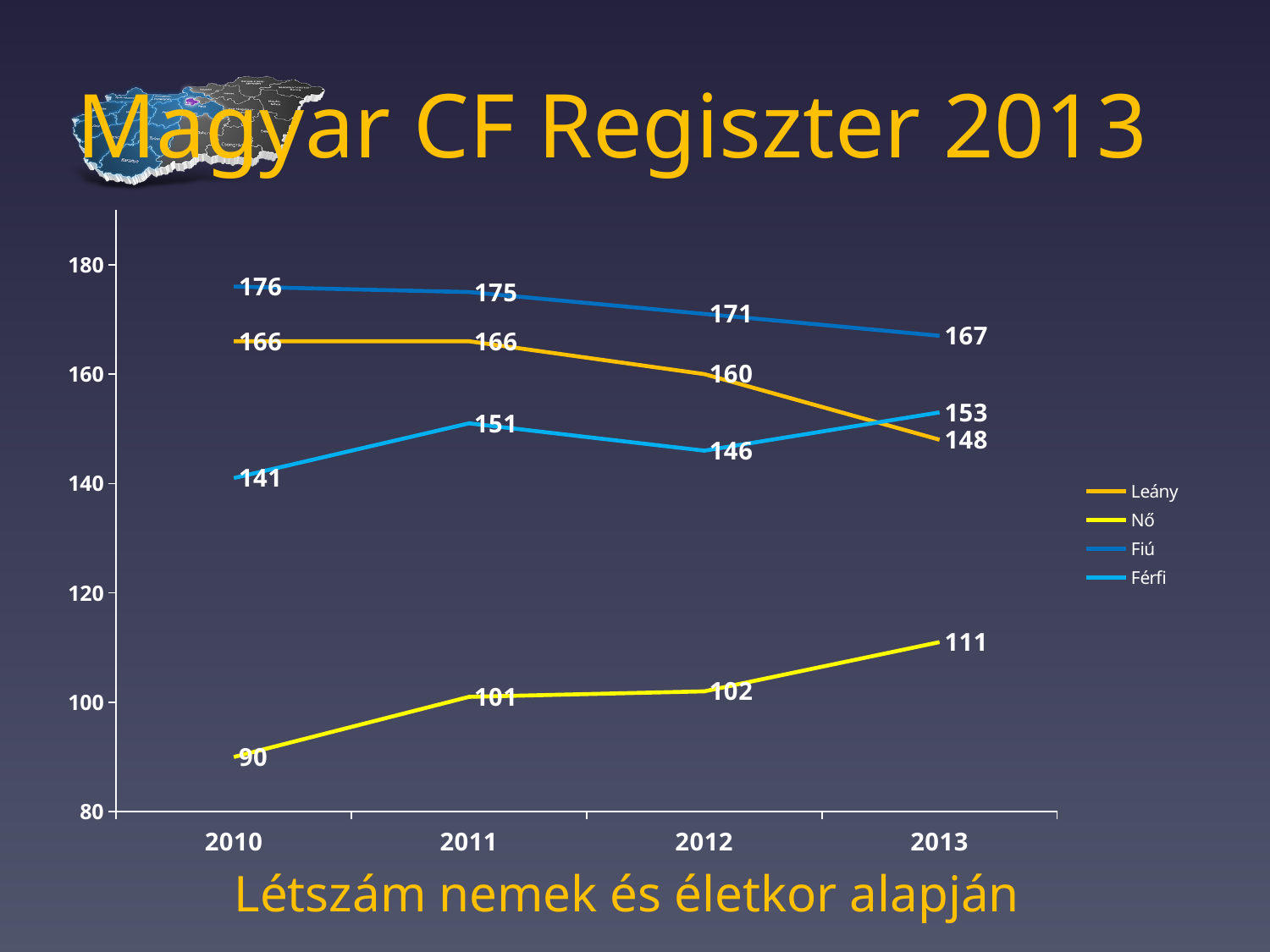
How many years are shown on the x axis? 4 What is the value for Leány in 2012? 160 What is the value for Férfi in 2011? 151 In which year is the Nő series lowest? 2010 What is the value for Nő in 2013? 111 What kind of chart is shown on the slide? line chart What is the difference between the Leány values in 2010 and 2013? 18 Does the Nő series rise or fall from 2010 to 2013? rise Which is larger in 2013, Férfi or Leány? Férfi In which year is the Fiú series highest? 2010 What is the value for Fiú in 2010? 176 How many series does the legend list? 4